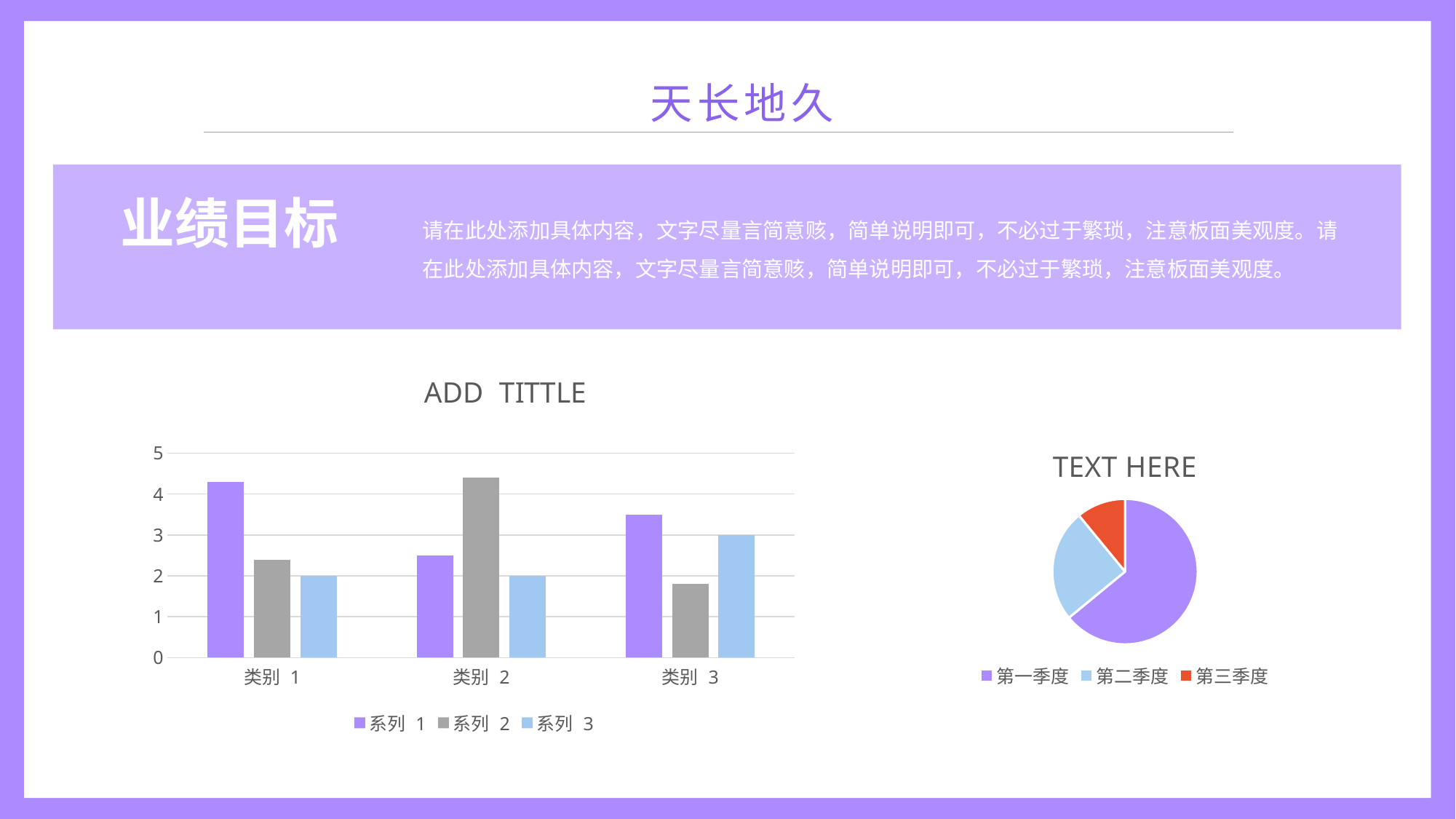
In the chart titled "TEXT HERE", which slice is the largest? 第一季度 In the chart titled "ADD TITTLE", is the value of 系列 2 for 类别 3 greater or less than 2? less What kind of chart is the chart titled "ADD TITTLE"? bar chart In the chart titled "ADD TITTLE", is the value of 系列 2 for 类别 2 greater or less than 4? greater In the chart titled "ADD TITTLE", how many series does the legend list? 3 In the chart titled "ADD TITTLE", which series has the highest bar for 类别 2? 系列 2 In the chart titled "ADD TITTLE", for 类别 1, which is larger: 系列 1 or 系列 3? 系列 1 What kind of chart is the chart titled "TEXT HERE"? pie chart In the chart titled "ADD TITTLE", which series has the lowest bar for 类别 3? 系列 2 In the chart titled "TEXT HERE", which slice is the smallest? 第三季度 In the chart titled "ADD TITTLE", is the value of 系列 1 for 类别 1 greater or less than 4? greater In the chart titled "ADD TITTLE", how many categories are shown on the x axis? 3